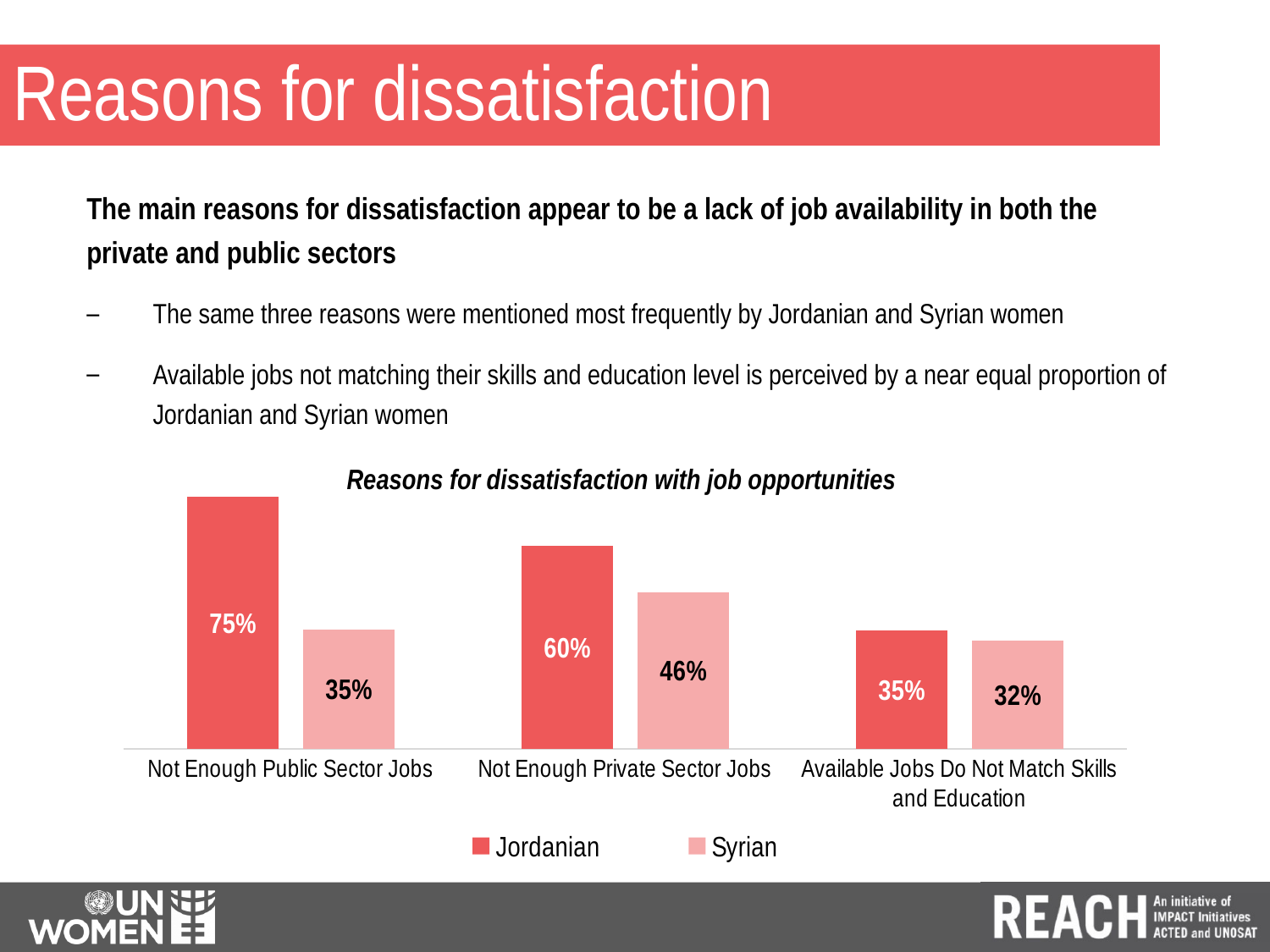
Which category has the lowest value for the Syrian series? Available Jobs Do Not Match Skills and Education What is the difference between the Jordanian and Syrian values for Not Enough Private Sector Jobs? 14% How many series does the legend list? 2 What is the value for Syrian women for Not Enough Private Sector Jobs? 46% What is the value for Syrian women for Available Jobs Do Not Match Skills and Education? 32% Which category has the highest value for the Jordanian series? Not Enough Public Sector Jobs What kind of chart is shown on the slide? Bar chart What is the title of the chart? Reasons for dissatisfaction with job opportunities Which is larger: the Jordanian value for Not Enough Private Sector Jobs or the Syrian value for Not Enough Private Sector Jobs? Jordanian What is the value for Jordanian women for Not Enough Public Sector Jobs? 75% What is the difference between the Jordanian and Syrian values for Not Enough Public Sector Jobs? 40% How many categories are shown on the x axis? 3